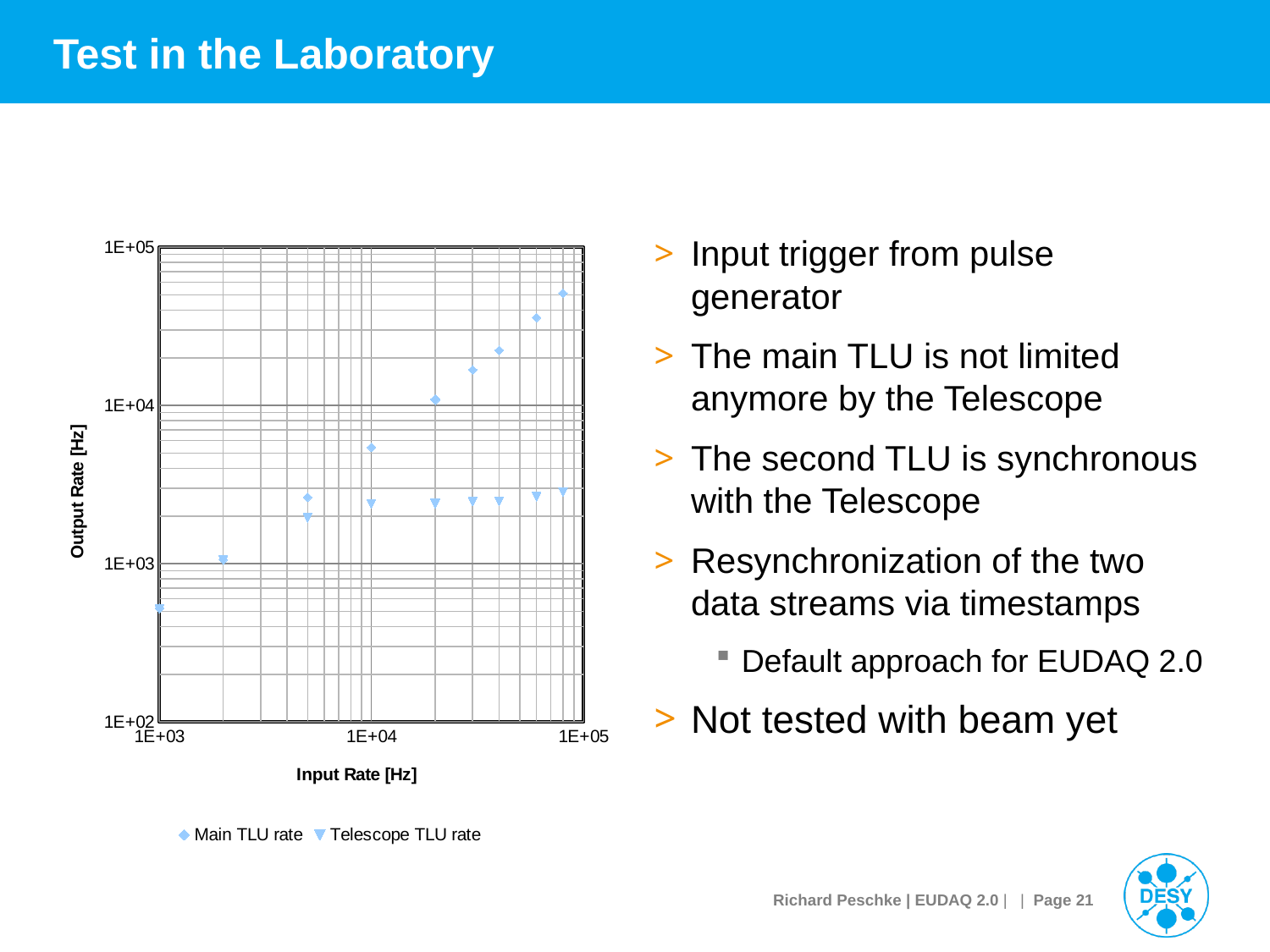
How many series does the chart legend list? 2 What are the two series named in the chart legend? Main TLU rate and Telescope TLU rate At the highest input rate plotted, which series has the higher output rate, Main TLU rate or Telescope TLU rate? Main TLU rate Is the Telescope TLU rate at an input rate of 1E+04 Hz greater or less than 1E+03 Hz? greater Does the Main TLU rate rise or fall as the input rate increases? Rises What kind of chart is shown on the slide? Scatter chart Is the Main TLU rate at an input rate of 1E+03 Hz greater or less than 1E+03 Hz? less Above an input rate of about 1E+04 Hz, does the Telescope TLU rate keep rising or stay roughly flat? Stays roughly flat What is the label of the chart's x axis? Input Rate [Hz]